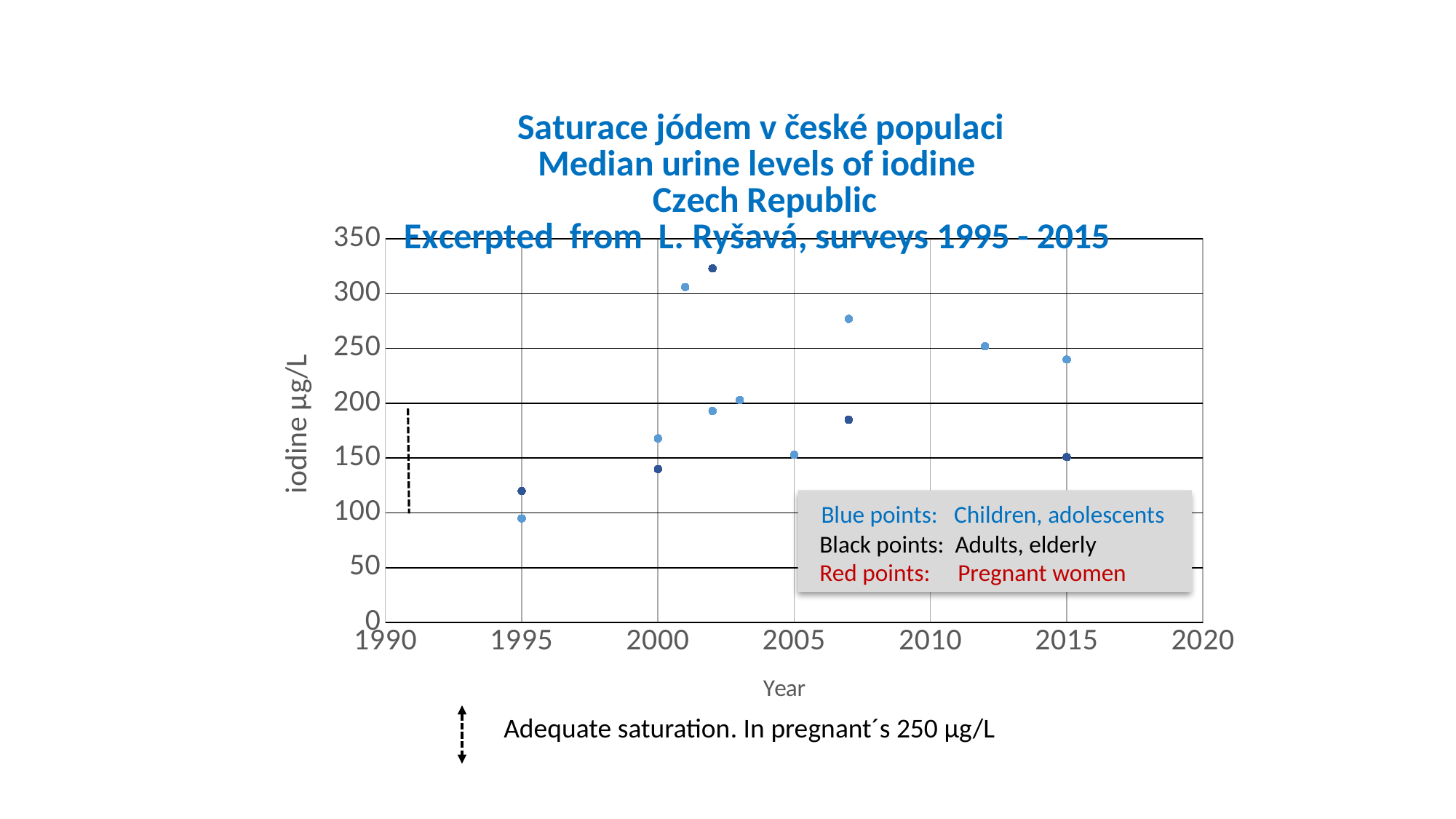
What kind of chart is shown on the slide? scatter chart In which year is the highest point on the chart plotted? 2002 Which is larger: the highest point plotted for 2002 or the highest point plotted for 2012? 2002 Is the lower of the two points plotted for 2000 greater or less than 150? less According to the legend, what do the blue points represent? Children, adolescents Is the higher of the two points plotted for 2015 greater or less than 250? less How many groups does the legend box list? 3 Is the higher of the two points plotted for 2007 greater or less than 250? greater What does the y axis of the chart measure? iodine µg/L In which year is the lowest point on the chart plotted? 1995